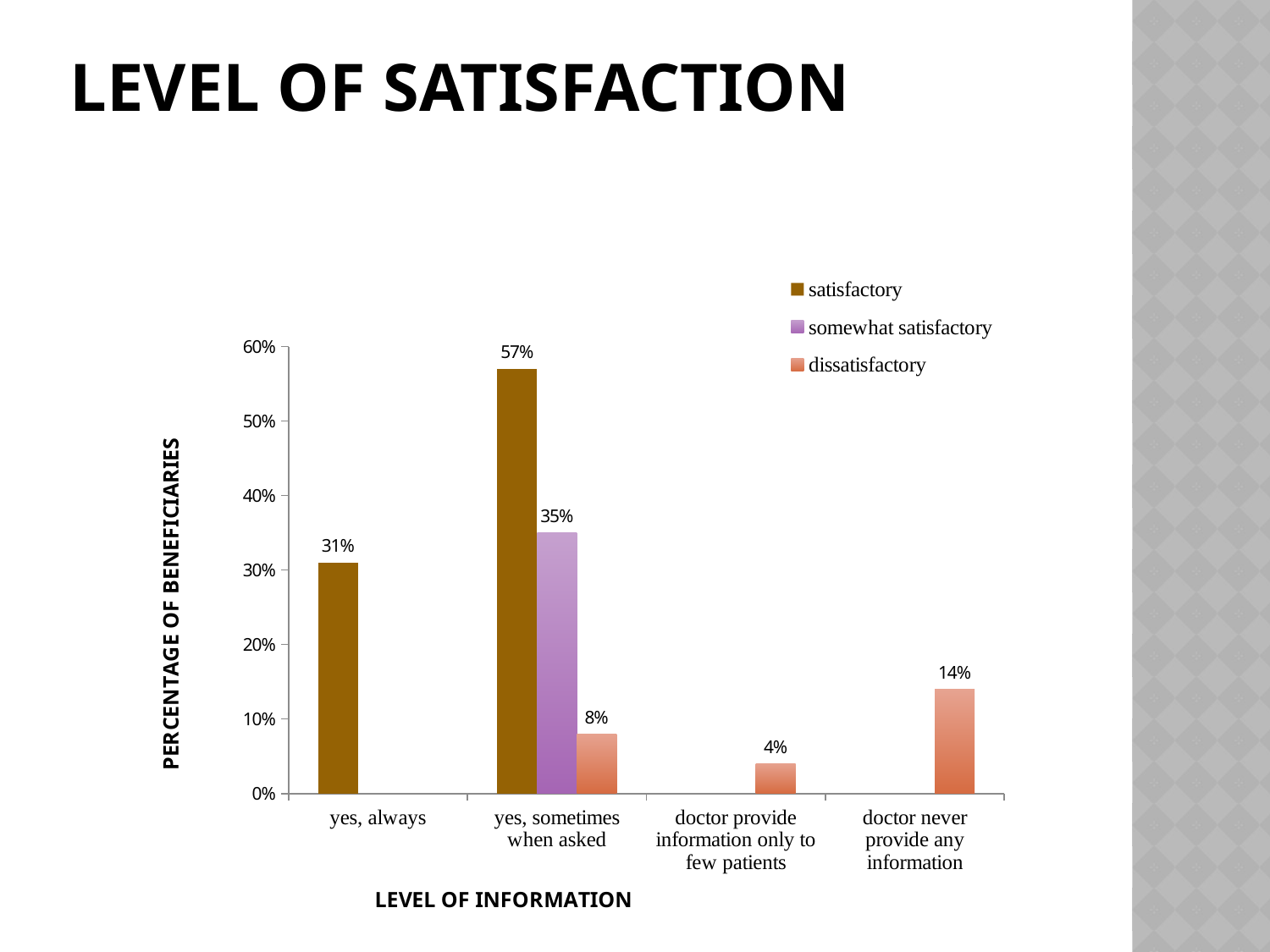
Which category has the lowest dissatisfactory value? doctor provide information only to few patients What is the title of the x axis? LEVEL OF INFORMATION Which is larger: the dissatisfactory value for 'yes, sometimes when asked' or for 'doctor never provide any information'? doctor never provide any information How many categories are shown on the x axis? 4 What is the value of the dissatisfactory series for the 'doctor never provide any information' category? 14% What is the value of the satisfactory series for the 'yes, always' category? 31% What is the value of the somewhat satisfactory series for the 'yes, sometimes when asked' category? 35% Which category has the highest satisfactory value? yes, sometimes when asked How many series does the legend list? 3 What is the value of the dissatisfactory series for the 'doctor provide information only to few patients' category? 4% What is the difference between the satisfactory values for 'yes, sometimes when asked' and 'yes, always'? 26% What kind of chart is shown on the slide? bar chart